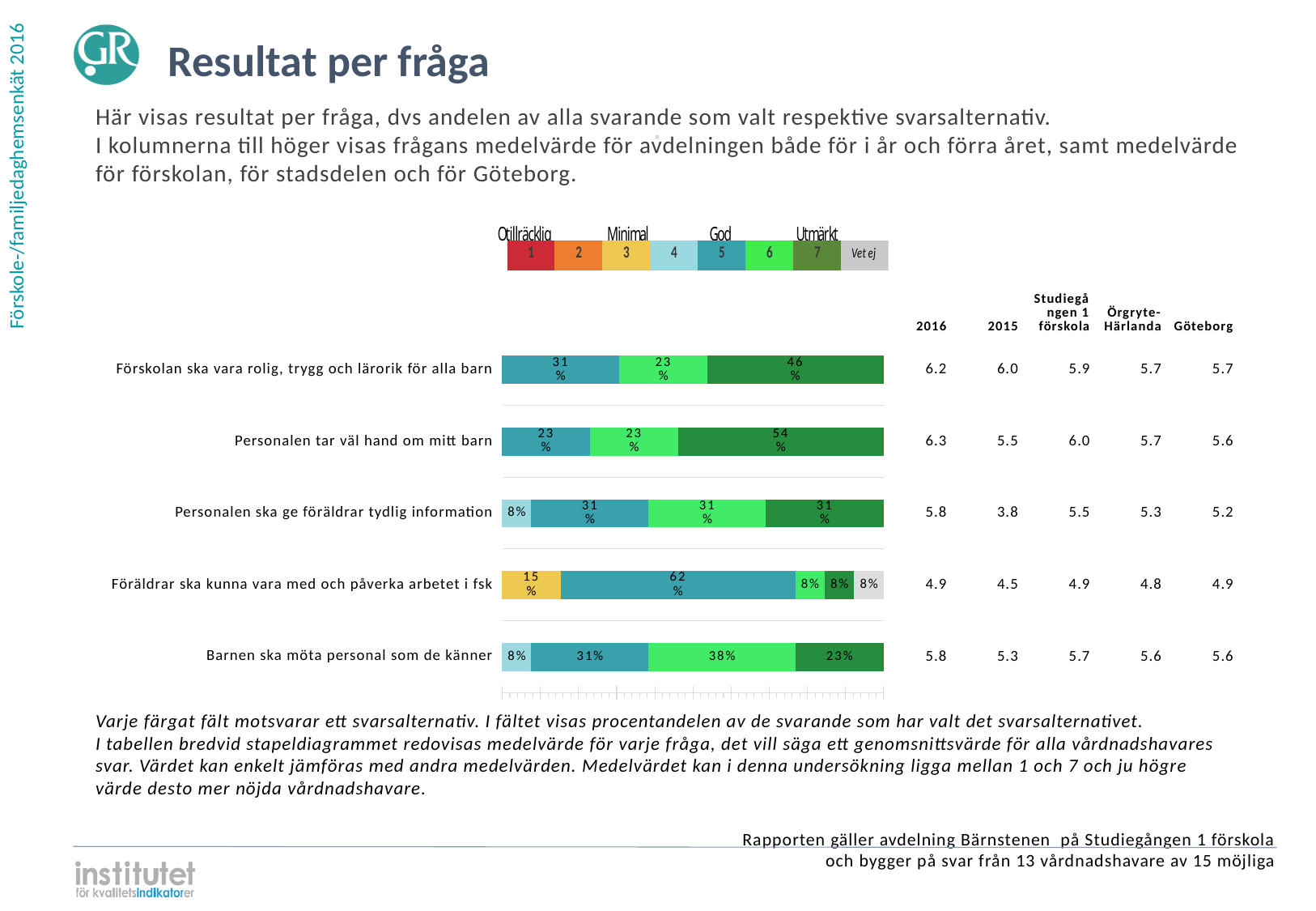
What percentage of respondents chose answer 5 (teal) for 'Föräldrar ska kunna vara med och påverka arbetet i fsk'? 62% Which question is the only one with a 'Vet ej' (grey) segment in its bar? Föräldrar ska kunna vara med och påverka arbetet i fsk Which question has the smallest share of respondents choosing answer 7 (dark green)? Föräldrar ska kunna vara med och påverka arbetet i fsk What is the combined share of answers 6 and 7 for 'Förskolan ska vara rolig, trygg och lärorik för alla barn'? 69% What percentage of respondents chose answer 7 (dark green) for 'Personalen tar väl hand om mitt barn'? 54% Which question has the largest share of respondents choosing answer 7 (dark green)? Personalen tar väl hand om mitt barn How many answer alternatives does the legend above the chart list, including 'Vet ej'? 8 What is the difference between the answer-7 share for 'Förskolan ska vara rolig, trygg och lärorik för alla barn' (46%) and for 'Barnen ska möta personal som de känner' (23%)? 23% What type of chart is shown on the slide? stacked bar chart What percentage of respondents chose answer 6 (light green) for 'Barnen ska möta personal som de känner'? 38% How many questions (categories) are plotted in the bar chart? 5 Is the answer-7 share larger for 'Personalen tar väl hand om mitt barn' or for 'Personalen ska ge föräldrar tydlig information'? Personalen tar väl hand om mitt barn